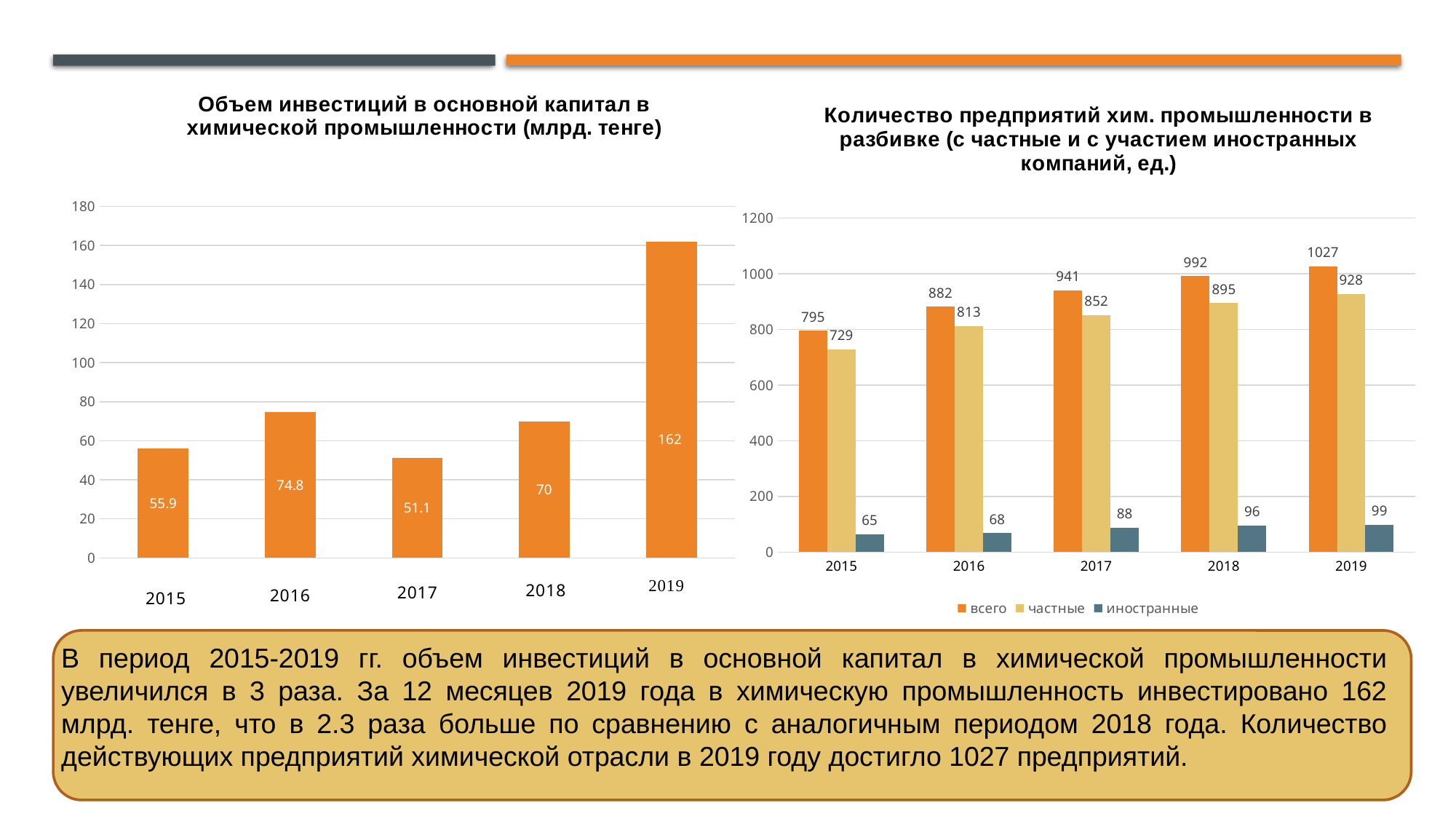
In the left chart (Объем инвестиций в основной капитал), what is the difference between the values for 2016 and 2015? 18.9 In the left chart (Объем инвестиций в основной капитал), how many years are shown on the x axis? 5 In the right chart (Количество предприятий хим. промышленности), what is the difference between всего in 2019 and всего in 2018? 35 In the right chart (Количество предприятий хим. промышленности), which series is shown in the dark teal colour? иностранные In the right chart (Количество предприятий хим. промышленности), what is the value for частные in 2017? 852 In the left chart (Объем инвестиций в основной капитал), which is larger: the value for 2018 or the value for 2017? 2018 In the left chart (Объем инвестиций в основной капитал), which year has the lowest value? 2017 In the right chart (Количество предприятий хим. промышленности), how many series does the legend list? 3 In the right chart (Количество предприятий хим. промышленности), what is the value for иностранные in 2015? 65 In the left chart (Объем инвестиций в основной капитал в химической промышленности), what is the value for 2019? 162 What kind of chart is the left chart (Объем инвестиций в основной капитал)? Bar chart In the right chart (Количество предприятий хим. промышленности), does the всего series rise or fall from 2015 to 2019? Rises